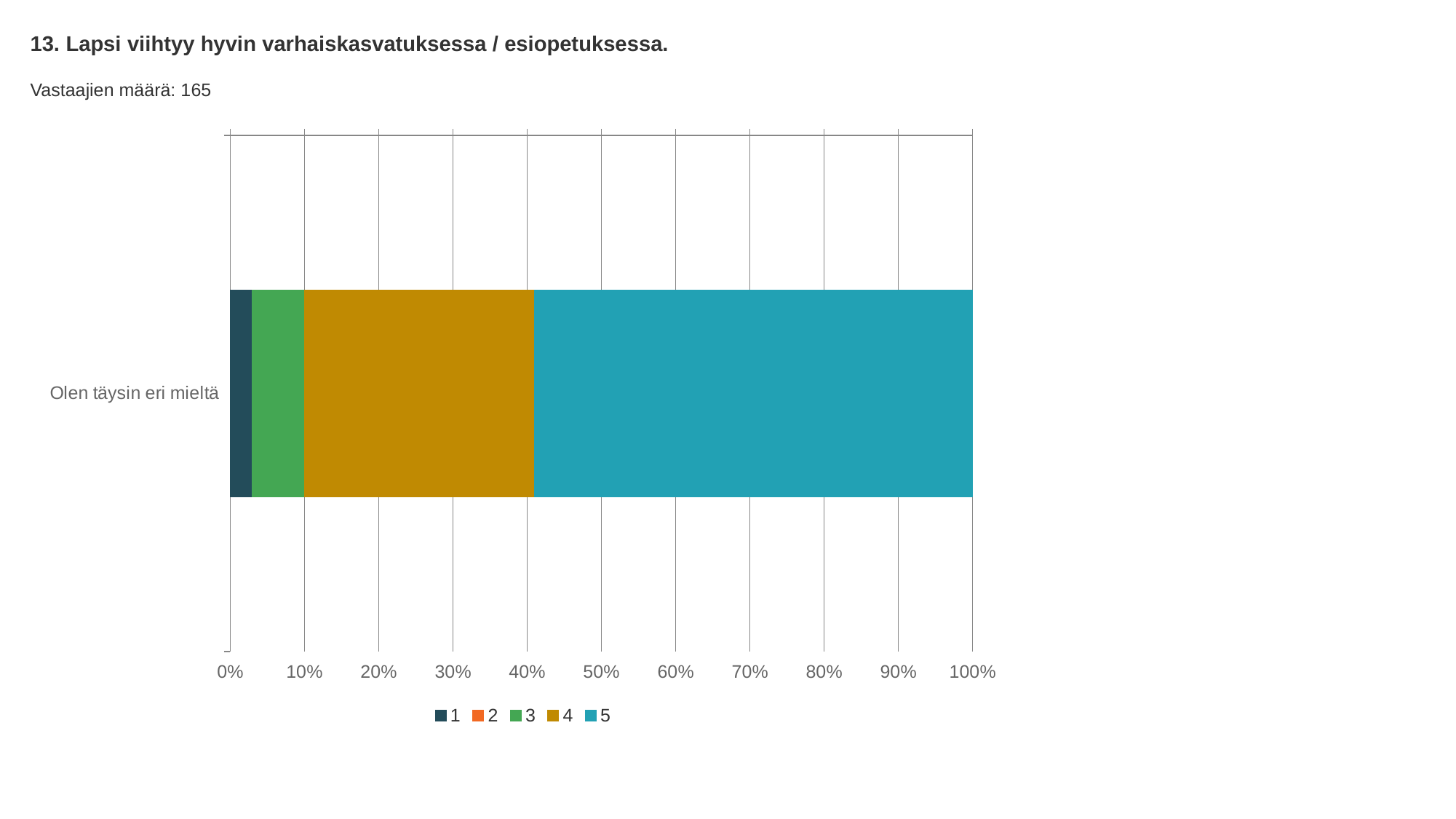
Which series has the larger segment, 1 or 3? 3 What kind of chart is shown on the slide? stacked bar chart Is the share for series 5 greater or less than 50%? greater How many categories are plotted on the y axis? 1 Is the share for series 4 greater or less than 40%? less How many series does the legend list? 5 Which series takes up the largest share of the bar? 5 Is the share for series 1 greater or less than 10%? less Which series has the larger segment, 3 or 4? 4 How many respondents (Vastaajien määrä) does the slide report? 165 Which series has the larger segment, 4 or 5? 5 What is the title of the chart? 13. Lapsi viihtyy hyvin varhaiskasvatuksessa / esiopetuksessa.